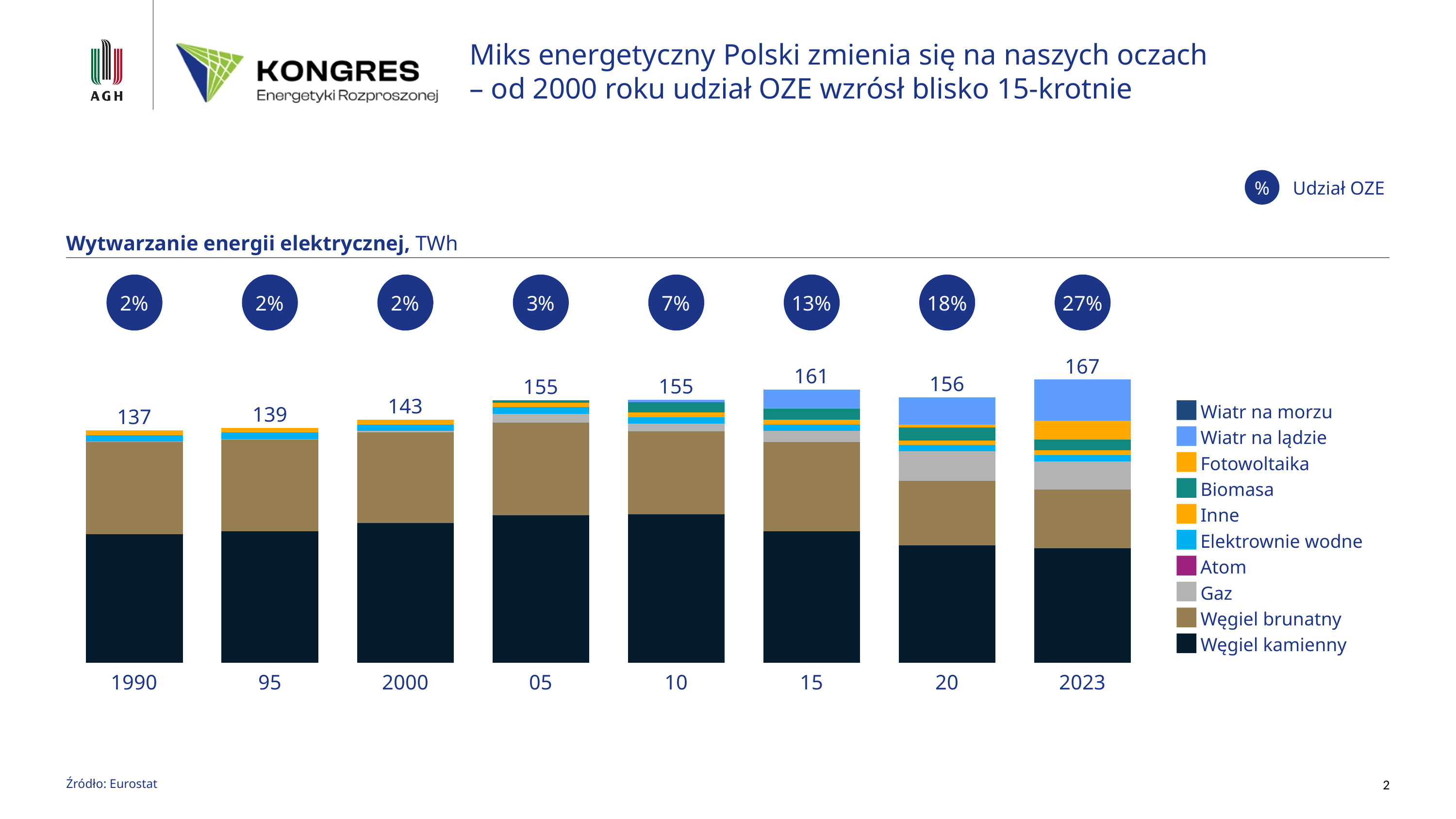
Does the OZE share rise or fall from 2000 to 2023? Rise How many years (bars) are shown in the chart? 8 What is the total electricity generation shown for 1990? 137 What kind of chart is shown on the slide? Stacked bar chart How many series does the legend list? 10 Which is larger, the total for 2015 or the total for 2020? 2015 What OZE share (Udział OZE) is shown above the bar for 2010? 7% Which year has the lowest total electricity generation? 1990 What is the total electricity generation shown for 2023? 167 What OZE share (Udział OZE) is shown above the bar for 2023? 27% Which year has the highest total electricity generation? 2023 What is the difference between the total for 2023 and the total for 2000? 24